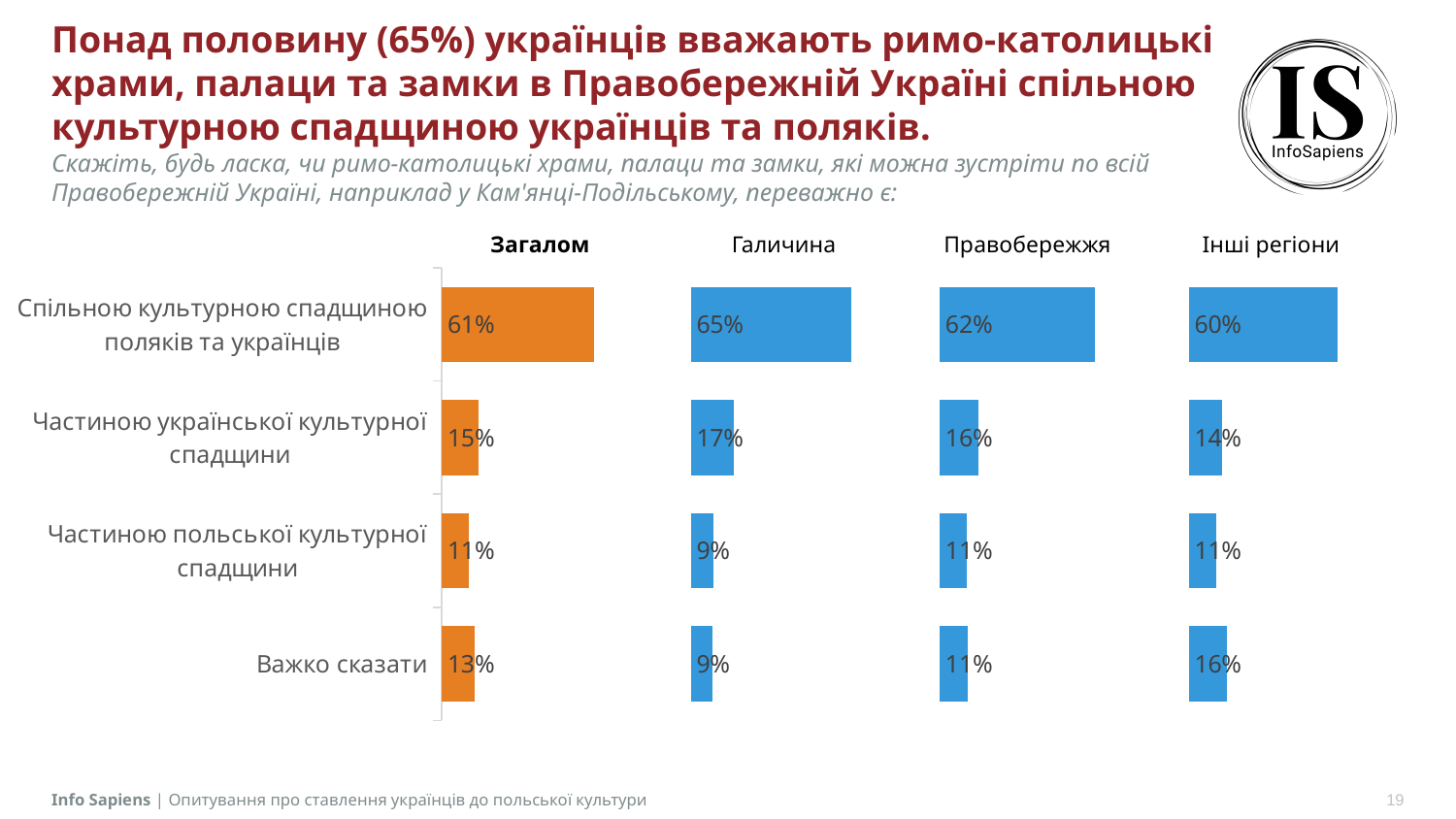
Which is larger: "Важко сказати" in the "Загалом" chart or "Важко сказати" in the "Галичина" chart? Загалом (13%) In the "Галичина" chart, which category has the lowest value? Частиною польської культурної спадщини and Важко сказати (both 9%) How many regional charts (columns) are shown on the slide? 4 In the "Інші регіони" chart, what is the value for "Важко сказати"? 16% In the "Правобережжя" chart, what is the value for "Частиною української культурної спадщини"? 16% In the "Загалом" chart, which category has the highest value? Спільною культурною спадщиною поляків та українців In the "Загалом" chart, what is the value for "Спільною культурною спадщиною поляків та українців"? 61% In the "Інші регіони" chart, what is the difference between "Спільною культурною спадщиною поляків та українців" and "Частиною української культурної спадщини"? 46 percentage points In the "Галичина" chart, what is the value for "Спільною культурною спадщиною поляків та українців"? 65% Which chart's bars are coloured orange rather than blue? Загалом What kind of chart is used on this slide? Bar chart How many categories are shown in each chart? 4